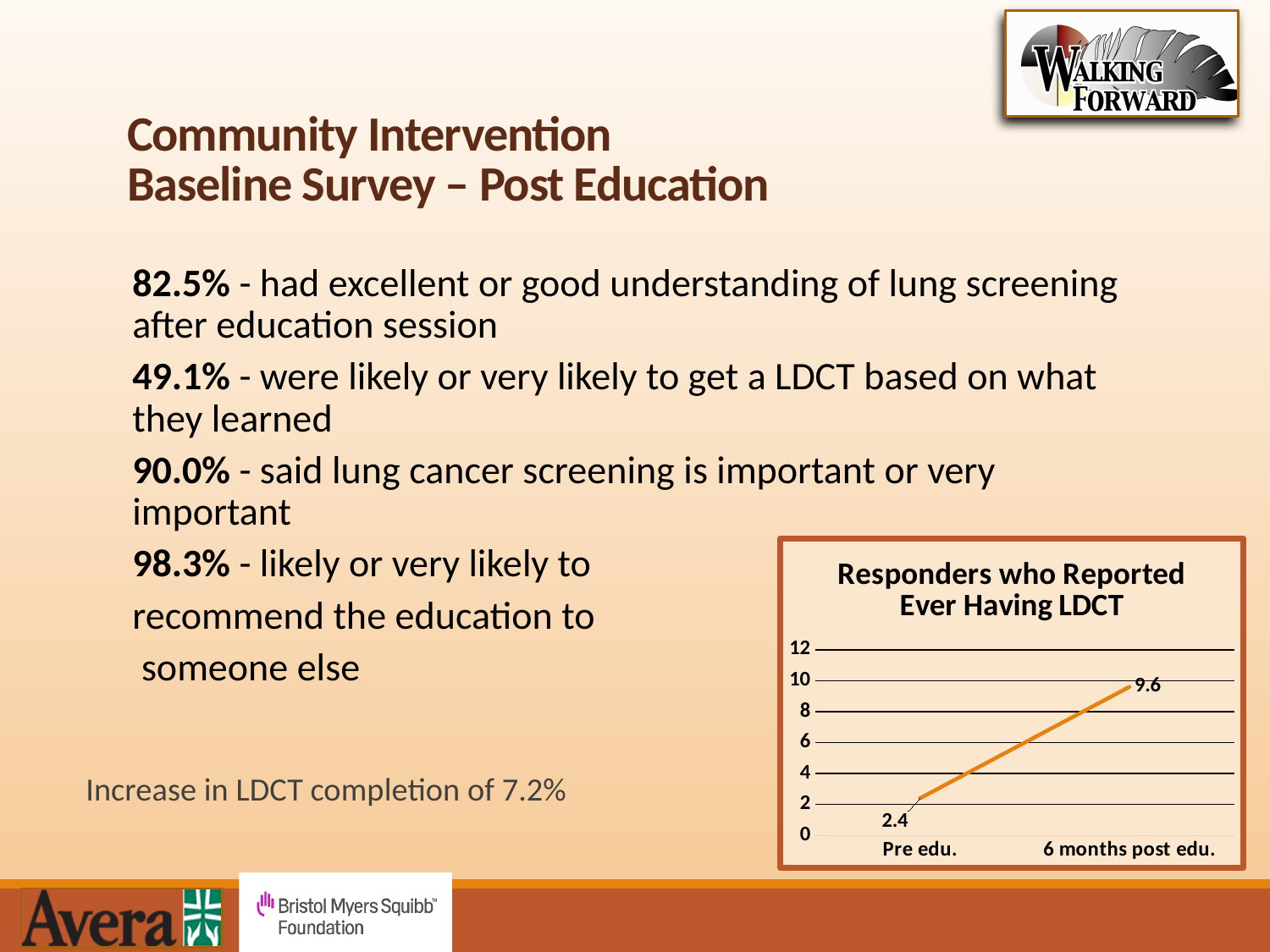
What is the difference between the 6 months post edu. value and the Pre edu. value? 7.2 Which category has the highest value in the chart? 6 months post edu. Is the value for Pre edu. greater or less than 4? less Which is larger, the value for Pre edu. or the value for 6 months post edu.? 6 months post edu. What is the value for 6 months post edu. in the chart? 9.6 Which category has the lowest value in the chart? Pre edu. Do the values rise or fall from Pre edu. to 6 months post edu.? rise Is the value for 6 months post edu. greater or less than 8? greater How many data points are plotted in the chart? 2 What is the title of the chart? Responders who Reported Ever Having LDCT What is the value for Pre edu. in the chart? 2.4 What kind of chart is shown on the slide? line chart